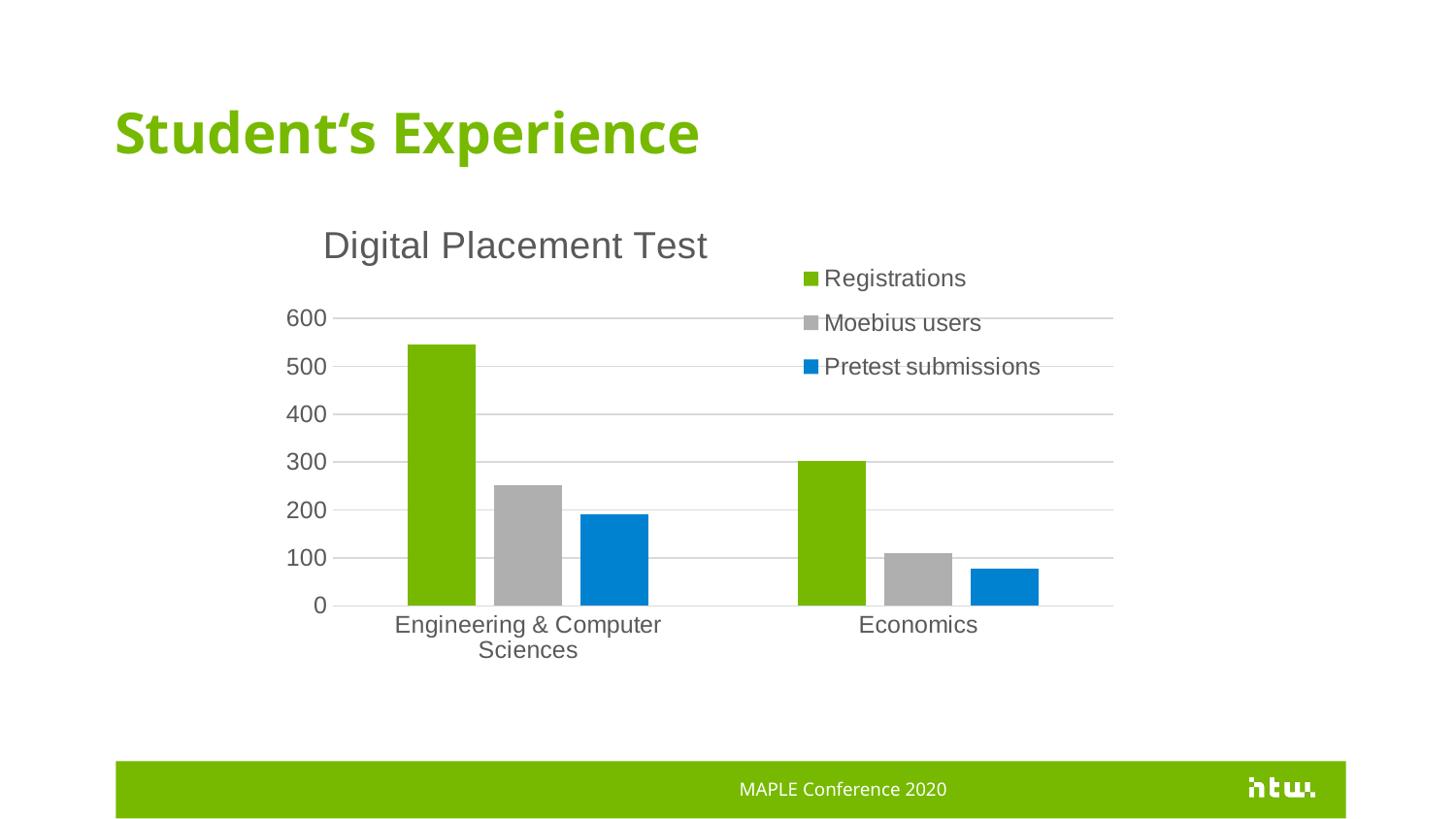
Which category has more Registrations, Engineering & Computer Sciences or Economics? Engineering & Computer Sciences What is the title of the chart? Digital Placement Test What kind of chart is shown on the slide? bar chart Is the value for Pretest submissions in Economics greater or less than 100? less Is the value for Moebius users in Engineering & Computer Sciences greater or less than 300? less How many series does the legend list? 3 Which series is shown in green? Registrations Is the value for Registrations in Economics greater or less than 400? less Which bar is the shortest in the chart? Pretest submissions for Economics How many categories are shown on the x axis? 2 Which bar is the tallest in the chart? Registrations for Engineering & Computer Sciences